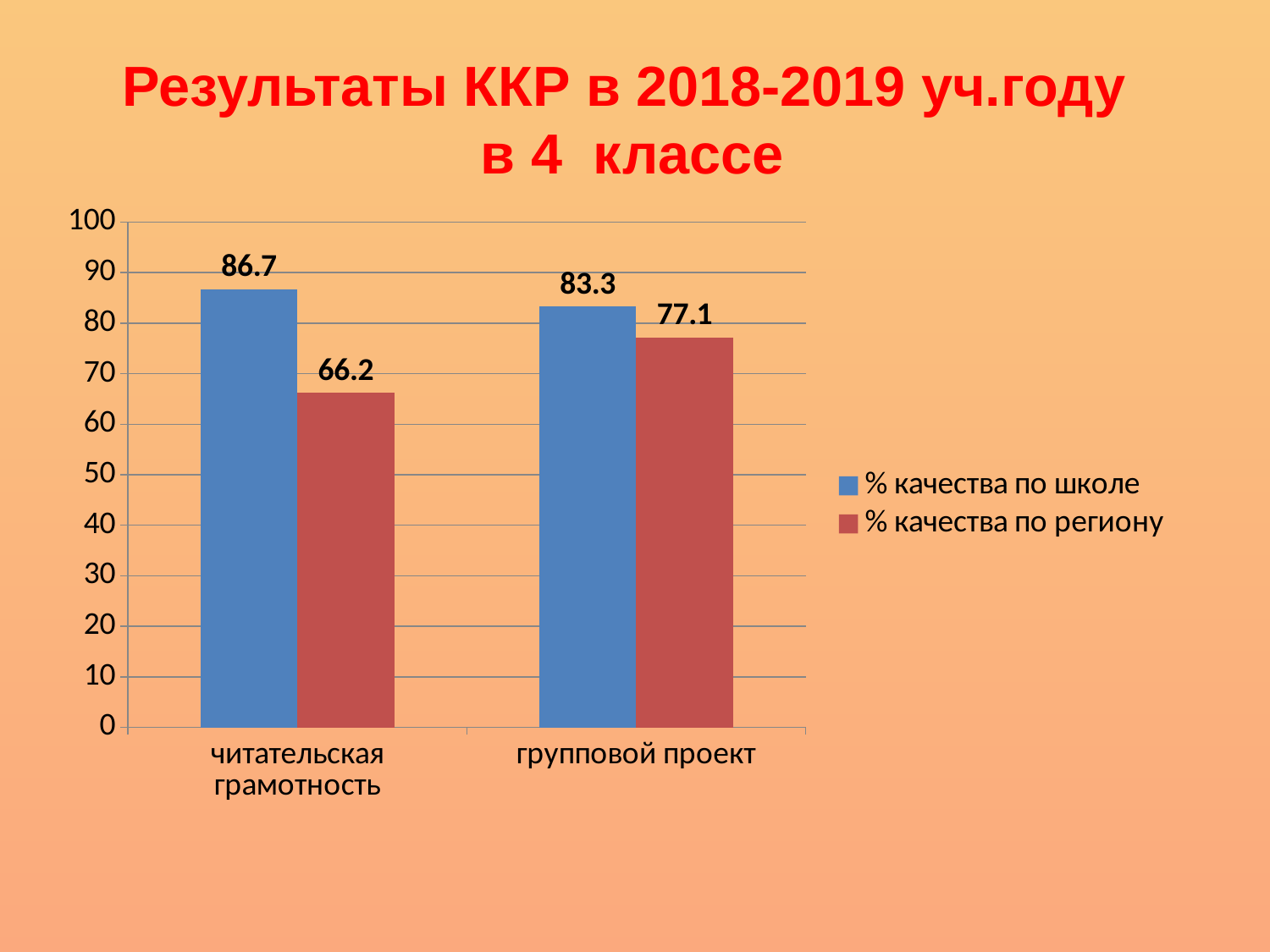
Which category has the lowest value for '% качества по региону'? читательская грамотность What is the difference between '% качества по школе' and '% качества по региону' for 'групповой проект'? 6.2 What kind of chart is shown on the slide? bar chart What is the value of '% качества по школе' for 'читательская грамотность'? 86.7 How many categories are shown on the x axis? 2 Which is larger for 'групповой проект': '% качества по школе' or '% качества по региону'? % качества по школе What is the value of '% качества по региону' for 'групповой проект'? 77.1 What is the difference between '% качества по школе' and '% качества по региону' for 'читательская грамотность'? 20.5 What is the value of '% качества по региону' for 'читательская грамотность'? 66.2 How many series does the legend list? 2 Which category has the highest value for '% качества по школе'? читательская грамотность What is the value of '% качества по школе' for 'групповой проект'? 83.3